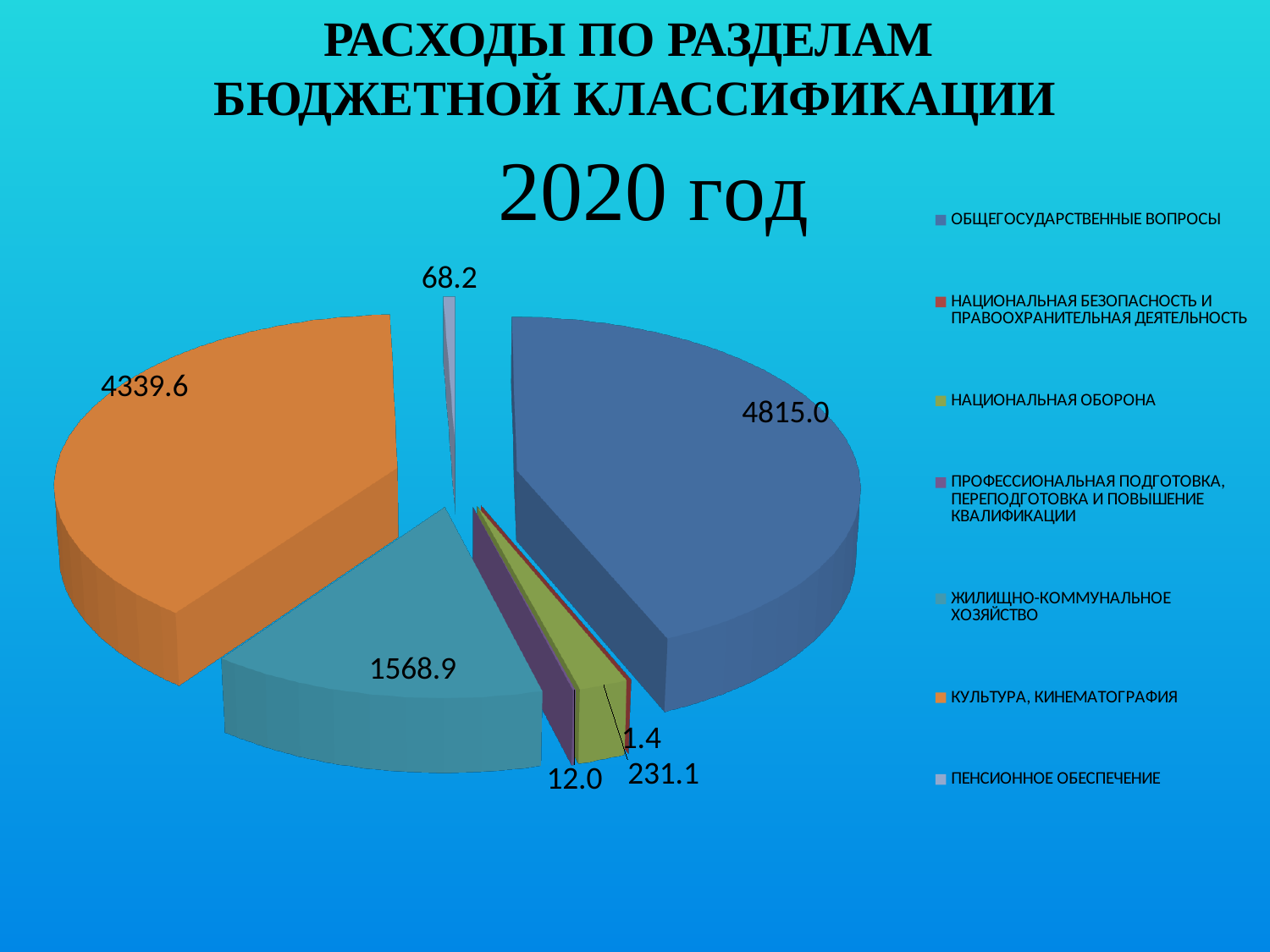
Which category has the smallest value? НАЦИОНАЛЬНАЯ БЕЗОПАСНОСТЬ И ПРАВООХРАНИТЕЛЬНАЯ ДЕЯТЕЛЬНОСТЬ What kind of chart is shown on the slide? pie chart Which year does the chart title refer to? 2020 год Which category has the largest value? ОБЩЕГОСУДАРСТВЕННЫЕ ВОПРОСЫ Which is larger, the value for ЖИЛИЩНО-КОММУНАЛЬНОЕ ХОЗЯЙСТВО or the value for НАЦИОНАЛЬНАЯ ОБОРОНА? ЖИЛИЩНО-КОММУНАЛЬНОЕ ХОЗЯЙСТВО What is the value for КУЛЬТУРА, КИНЕМАТОГРАФИЯ? 4339.6 What is the value for НАЦИОНАЛЬНАЯ ОБОРОНА? 231.1 What is the value for ОБЩЕГОСУДАРСТВЕННЫЕ ВОПРОСЫ? 4815.0 What is the value for ЖИЛИЩНО-КОММУНАЛЬНОЕ ХОЗЯЙСТВО? 1568.9 What is the difference between the values for ОБЩЕГОСУДАРСТВЕННЫЕ ВОПРОСЫ and КУЛЬТУРА, КИНЕМАТОГРАФИЯ? 475.4 How many categories does the legend list? 7 What is the value for ПЕНСИОННОЕ ОБЕСПЕЧЕНИЕ? 68.2